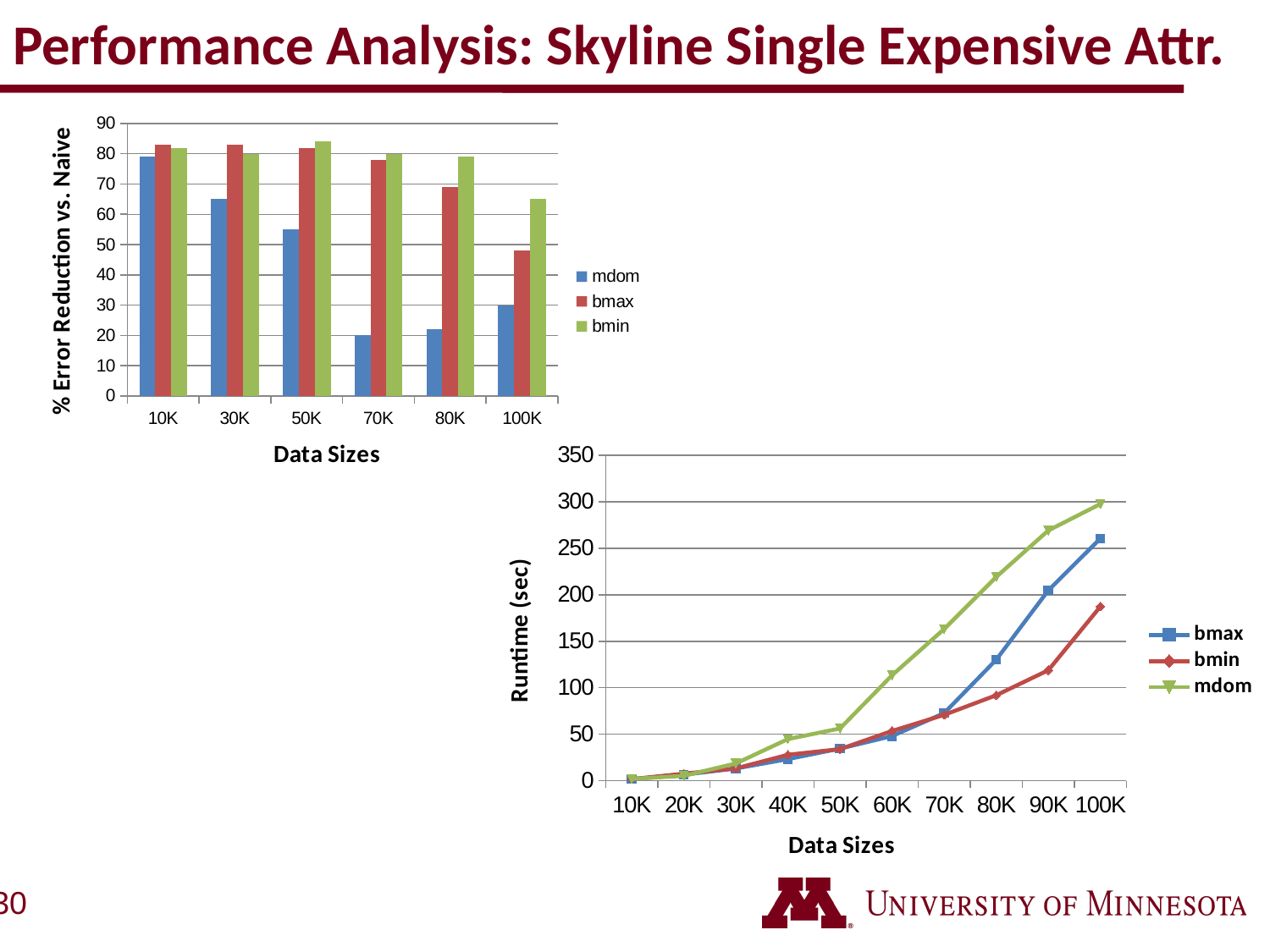
In the top-left bar chart, is the mdom value at 10K greater or less than 70? greater In the top-left bar chart, how many series does the legend list? 3 In the top-left bar chart, at which data size is the mdom bar lowest? 70K What kind of chart is the bottom-right chart with the y-axis 'Runtime (sec)'? line chart In the top-left bar chart, how many data size categories are shown on the x axis? 6 In the top-left bar chart, is the bmin value at 100K greater or less than 60? greater In the bottom-right line chart, does the mdom runtime rise or fall as data size increases from 10K to 100K? rise In the bottom-right line chart, how many data size points are shown on the x axis? 10 What kind of chart is the top-left chart titled with the y-axis '% Error Reduction vs. Naive'? bar chart In the bottom-right line chart, which series has the highest runtime at 100K? mdom In the bottom-right line chart, at 80K, which series has the larger runtime, mdom or bmax? mdom In the bottom-right line chart, is the bmin runtime at 100K greater or less than 200? less